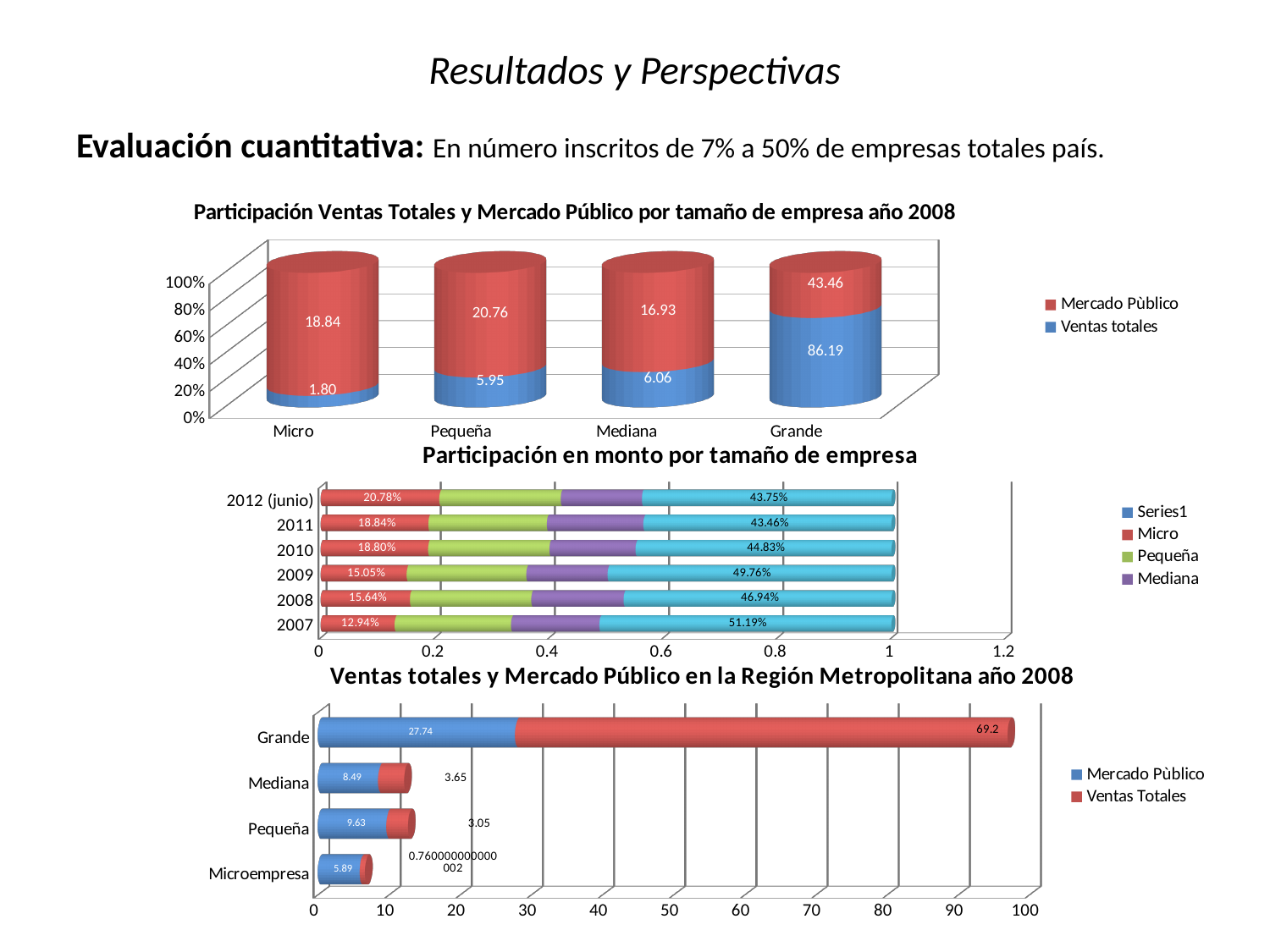
In the chart 'Participación en monto por tamaño de empresa', what is the Micro value for 2009? 15.05% In the chart 'Participación en monto por tamaño de empresa', how many years are listed on the vertical axis? 6 In the chart 'Ventas totales y Mercado Público en la Región Metropolitana año 2008', what is the Ventas Totales value for Grande? 69.2 In the chart 'Participación Ventas Totales y Mercado Público por tamaño de empresa año 2008', what is the Mercado Público value for Pequeña? 20.76 In the chart 'Participación Ventas Totales y Mercado Público por tamaño de empresa año 2008', what is the Ventas totales value for Grande? 86.19 In the chart 'Participación Ventas Totales y Mercado Público por tamaño de empresa año 2008', what is the difference between the Mercado Público values for Pequeña and Mediana? 3.83 In the chart 'Participación en monto por tamaño de empresa', what is the value printed on the rightmost (cyan) segment for 2007? 51.19% In the chart 'Ventas totales y Mercado Público en la Región Metropolitana año 2008', which is larger for Mediana: Mercado Público or Ventas Totales? Mercado Público In the chart 'Participación Ventas Totales y Mercado Público por tamaño de empresa año 2008', how many company-size categories are shown? 4 In the chart 'Participación Ventas Totales y Mercado Público por tamaño de empresa año 2008', which company size has the lowest Ventas totales value? Micro In the chart 'Participación en monto por tamaño de empresa', which year has the highest Micro value? 2012 (junio) What type of chart is 'Ventas totales y Mercado Público en la Región Metropolitana año 2008'? Stacked bar chart